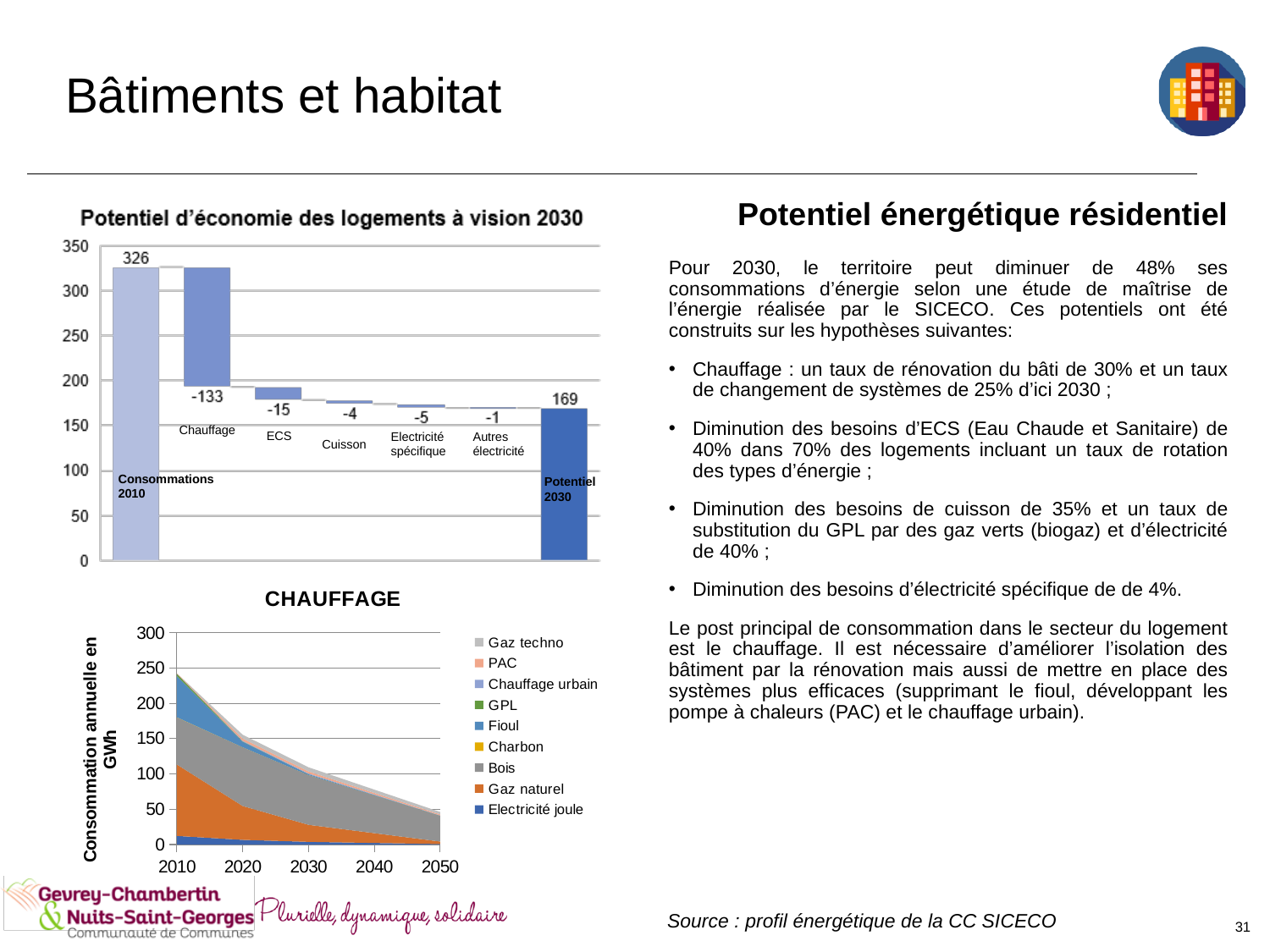
In the CHAUFFAGE chart, does total annual consumption rise or fall from 2010 to 2050? fall In the chart 'Potentiel d'économie des logements à vision 2030', what is the value labelled for Potentiel 2030? 169 In the chart 'Potentiel d'économie des logements à vision 2030', which reduction step has the smallest magnitude? Autres électricité In the chart 'Potentiel d'économie des logements à vision 2030', what is the value labelled for Consommations 2010? 326 In the chart 'Potentiel d'économie des logements à vision 2030', what is the value shown for Chauffage? -133 In the chart 'Potentiel d'économie des logements à vision 2030', which reduction step has the largest magnitude? Chauffage In the chart 'Potentiel d'économie des logements à vision 2030', is the reduction for Cuisson larger or smaller in magnitude than the reduction for Electricité spécifique? smaller In the chart 'Potentiel d'économie des logements à vision 2030', what is the difference between Consommations 2010 and Potentiel 2030? 157 In the chart 'Potentiel d'économie des logements à vision 2030', what is the value shown for ECS? -15 How many series does the legend of the CHAUFFAGE chart list? 9 In the CHAUFFAGE chart, is the total consumption in 2010 greater or less than 200 GWh? greater In the chart 'Potentiel d'économie des logements à vision 2030', what is the value shown for Electricité spécifique? -5